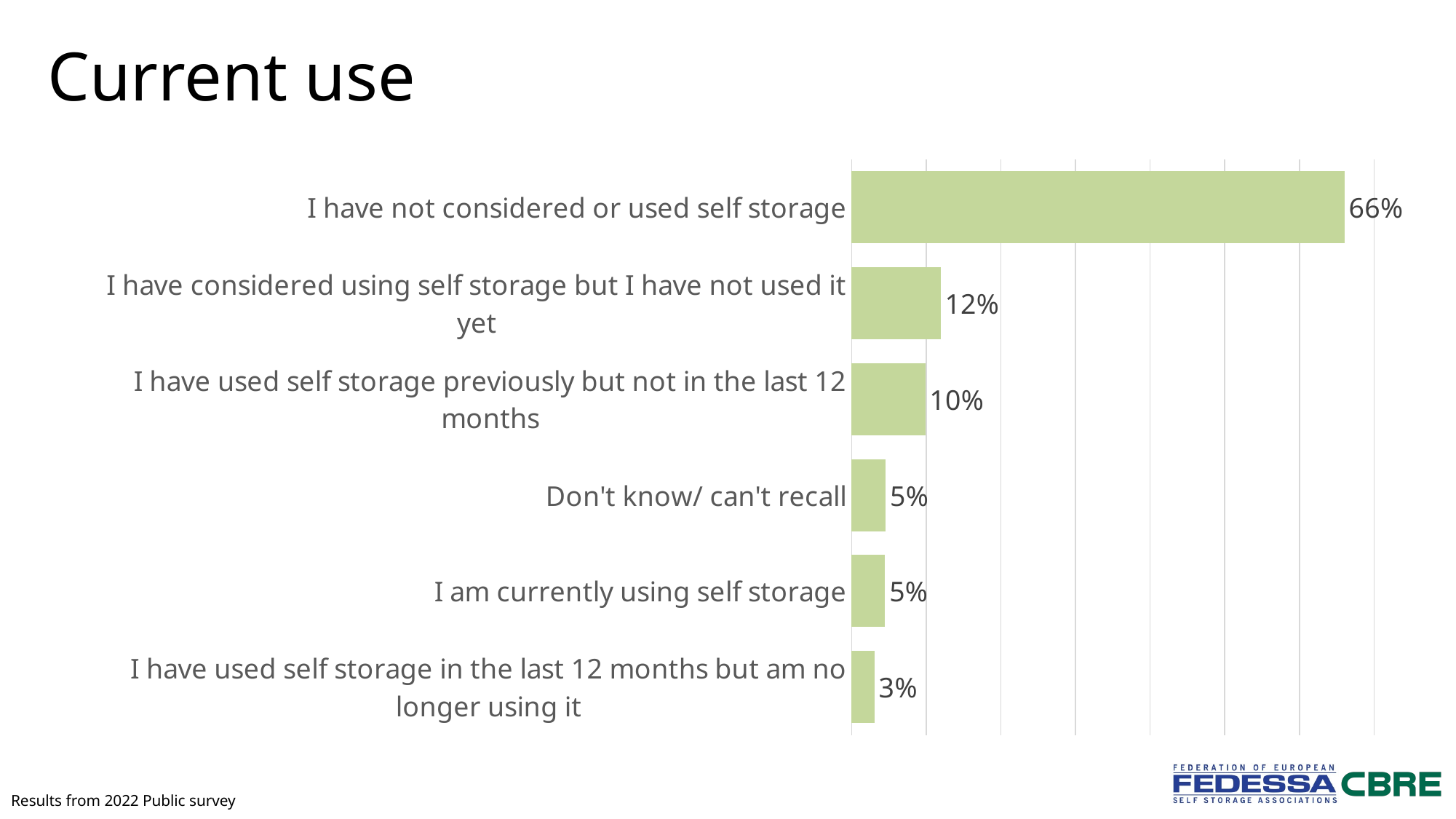
What is the value for 'I am currently using self storage'? 5% What is the difference between 'I have considered using self storage but I have not used it yet' and 'I have used self storage previously but not in the last 12 months'? 2% How many categories are shown in the chart? 6 What percentage of respondents have used self storage previously but not in the last 12 months? 10% Which category has the lowest value? I have used self storage in the last 12 months but am no longer using it Which category has the highest value? I have not considered or used self storage What percentage of respondents have used self storage in the last 12 months but are no longer using it? 3% What is the difference between 'I have not considered or used self storage' and 'I have considered using self storage but I have not used it yet'? 54% What kind of chart is shown on the slide? Bar chart What is the value for 'I have considered using self storage but I have not used it yet'? 12% What percentage of respondents said they have not considered or used self storage? 66% Which is larger: 'I have used self storage previously but not in the last 12 months' or 'Don't know/ can't recall'? I have used self storage previously but not in the last 12 months